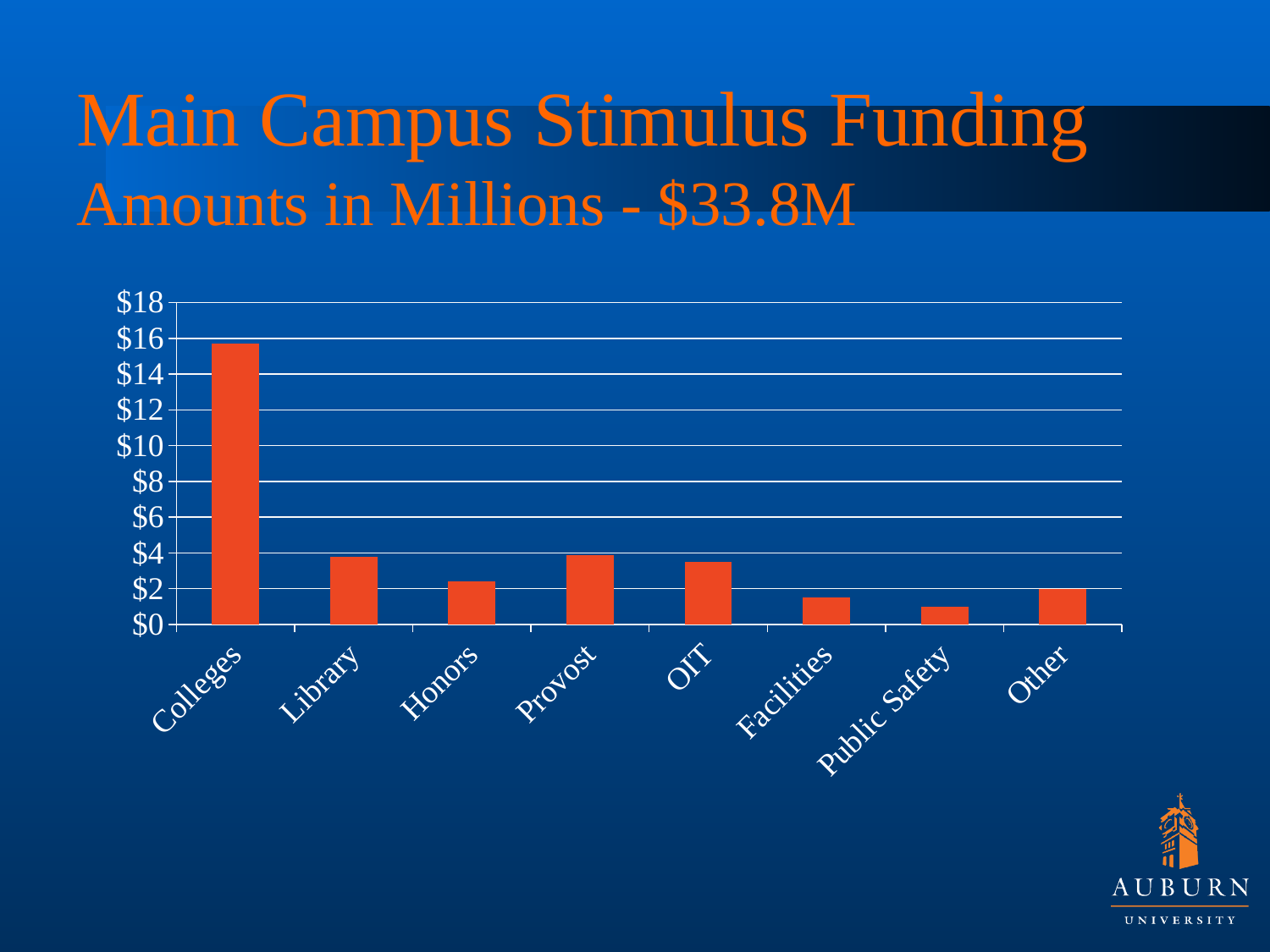
Is the value for OIT greater or less than $2? greater Which is larger, the value for Colleges or the value for Library? Colleges Is the value for Facilities greater or less than $2? less What total amount is stated in the slide's subtitle? $33.8M Which is larger, the value for Honors or the value for Facilities? Honors How many categories are shown on the x axis of the chart? 8 Is the value for Colleges greater or less than $14? greater Which category has the lowest value in the chart? Public Safety What kind of chart is shown on the slide? bar chart Which category has the highest value in the chart? Colleges